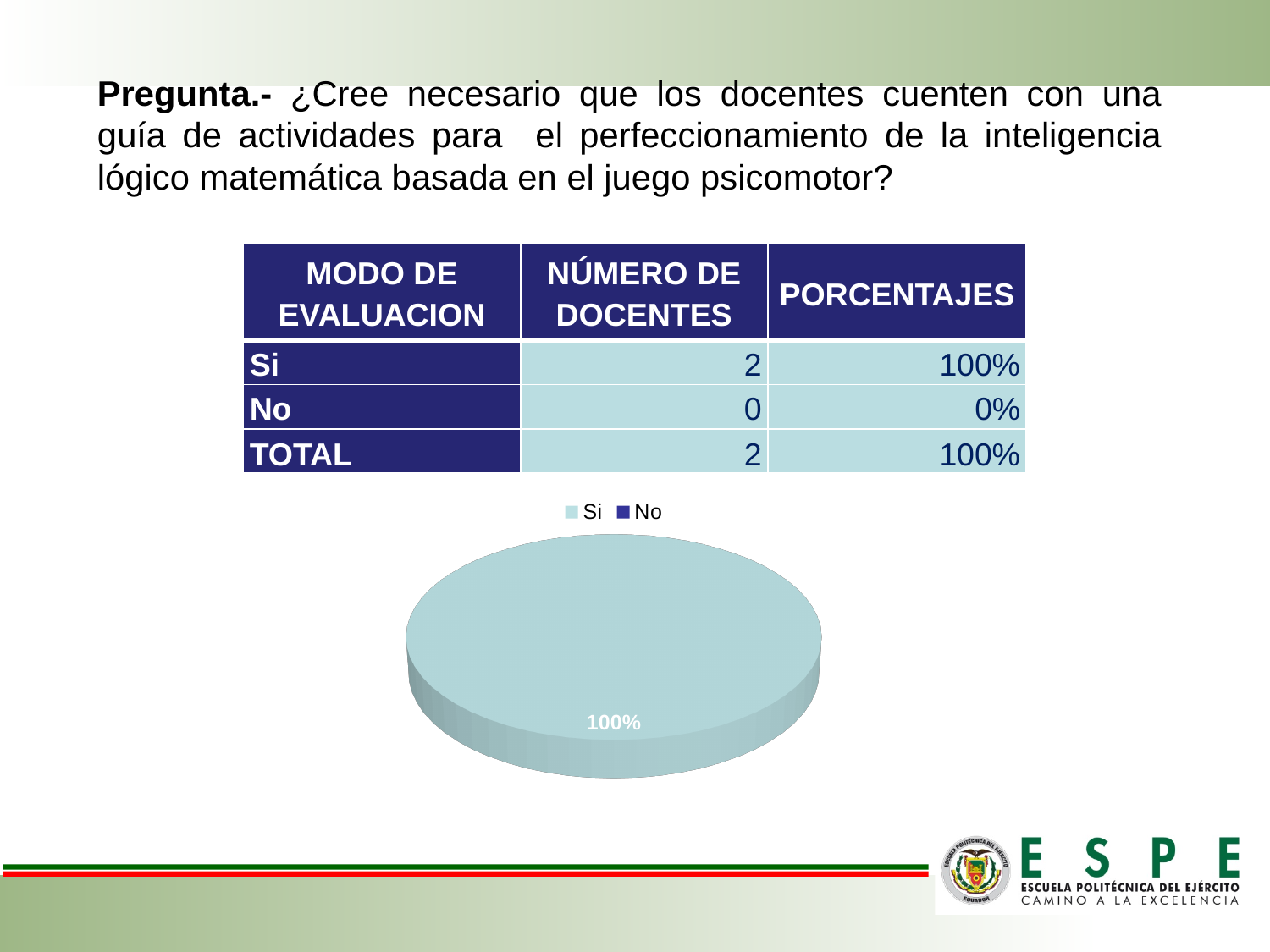
How many visible slices does the pie chart have? 1 Which is larger in the pie chart, the share for "Si" or the share for "No"? Si What kind of chart is shown on the slide? pie chart What share of the pie does the "Si" slice represent? 100% What data label is printed on the pie chart? 100% How many series does the chart legend list? 2 Which category has the largest share of the pie? Si Which category has the smallest share of the pie? No What are the two legend entries of the pie chart? Si, No What colour is the "Si" slice in the pie chart? light blue